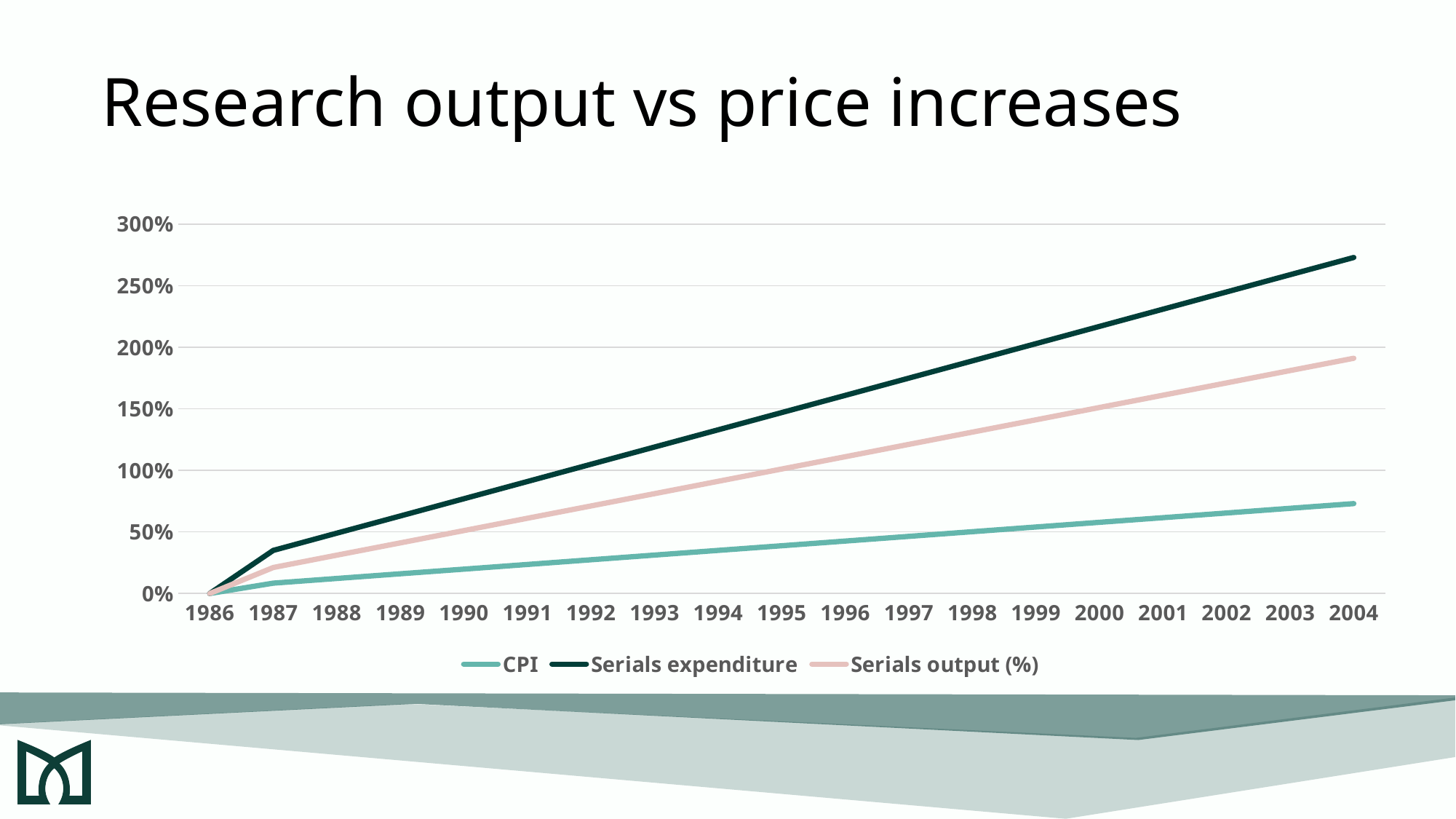
What kind of chart is shown on the slide? Line chart What is the title of the slide containing the chart? Research output vs price increases Is the value for Serials expenditure in 1990 greater or less than 50%? greater Do the values for Serials expenditure rise or fall from 1986 to 2004? Rise Is the value for Serials expenditure in 2004 greater or less than 250%? greater Is the value for Serials output (%) in 2004 greater or less than 200%? less Which series has the lowest value in 2004? CPI How many series does the legend list? 3 How many years are shown along the x axis? 19 In 2000, which is larger: Serials output (%) or CPI? Serials output (%) Which series has the highest value in 2004? Serials expenditure